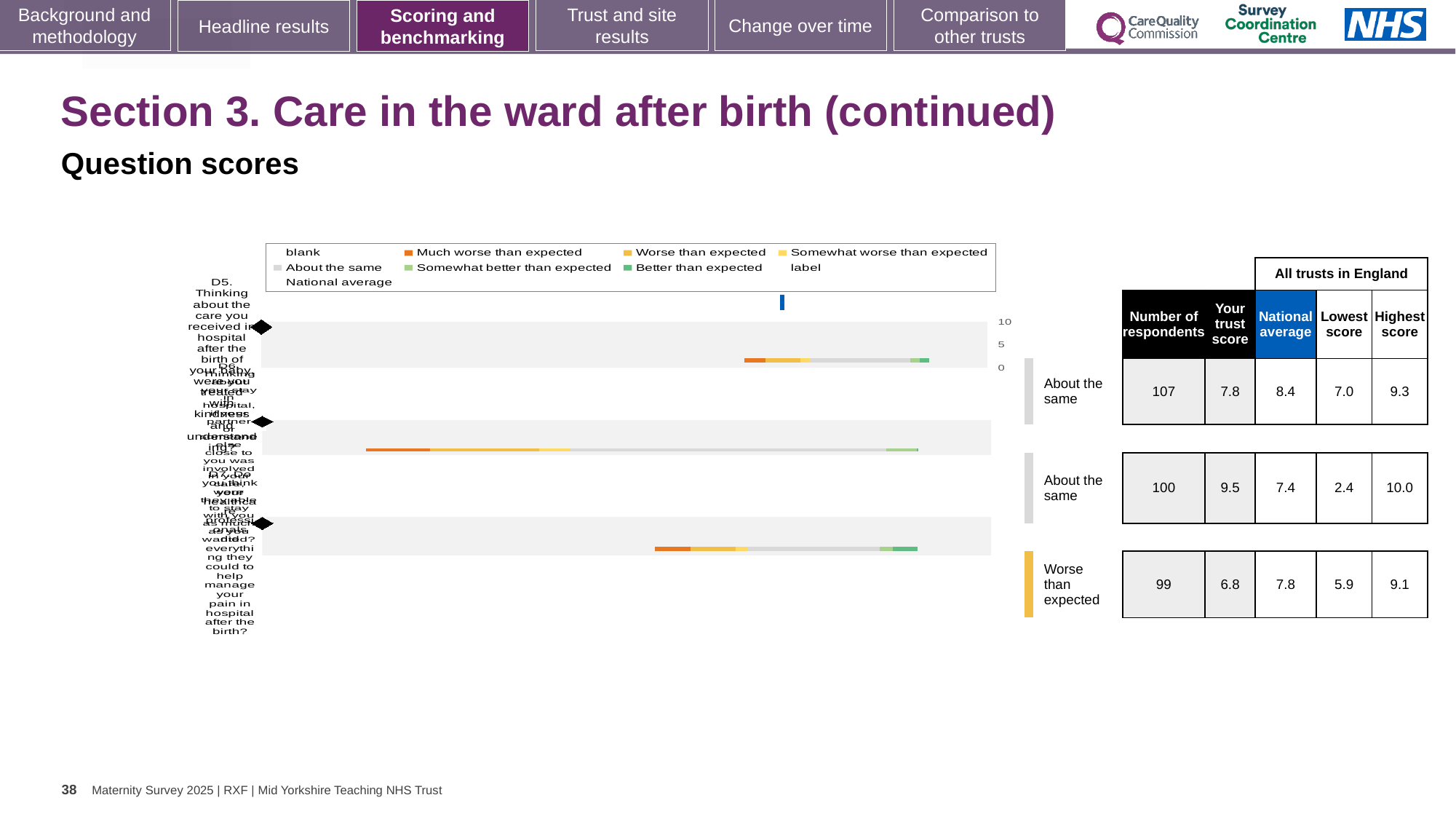
What kind of chart is shown on the slide? Bar chart For the row rated 'Worse than expected', what is your trust score? 6.8 How many entries does the chart legend list? 9 What is the highest tick value shown on the chart's score axis? 10 For the row rated 'Worse than expected', what is the difference between the national average and your trust score? 1.0 For the row rated 'Worse than expected', what is the national average? 7.8 Which legend entry is shown in orange? Much worse than expected How many question rows (bars) are plotted in the chart? 3 For the row rated 'Worse than expected', what is the number of respondents? 99 What is the smallest 'Lowest score' value shown in the table? 2.4 What is the largest 'Highest score' value shown in the table? 10.0 For the row rated 'Worse than expected', which is larger: your trust score or the national average? National average